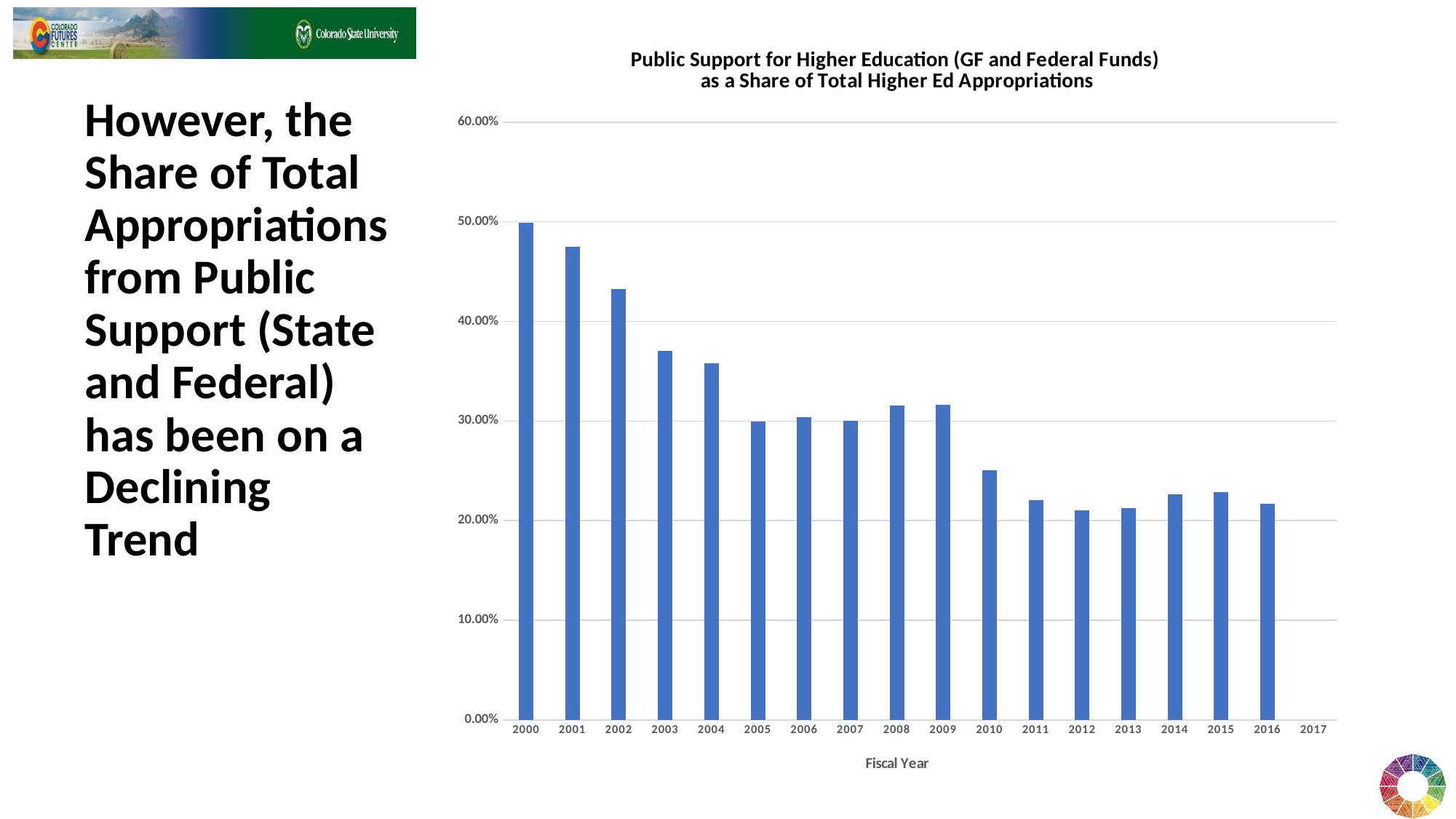
Which fiscal year has the highest share of total higher ed appropriations? 2000 Is the value for 2002 greater or less than 40.00%? greater Is the value for 2001 greater or less than 50.00%? less How many bars are plotted on the chart? 17 Do the values generally rise or fall from 2000 to 2016? fall Which is larger, the value for 2000 or the value for 2016? 2000 What kind of chart is shown on the slide? bar chart What is the label on the x axis of the chart? Fiscal Year Is the value for 2003 greater or less than 40.00%? less What is the title of the chart? Public Support for Higher Education (GF and Federal Funds) as a Share of Total Higher Ed Appropriations Which is larger, the value for 2009 or the value for 2010? 2009